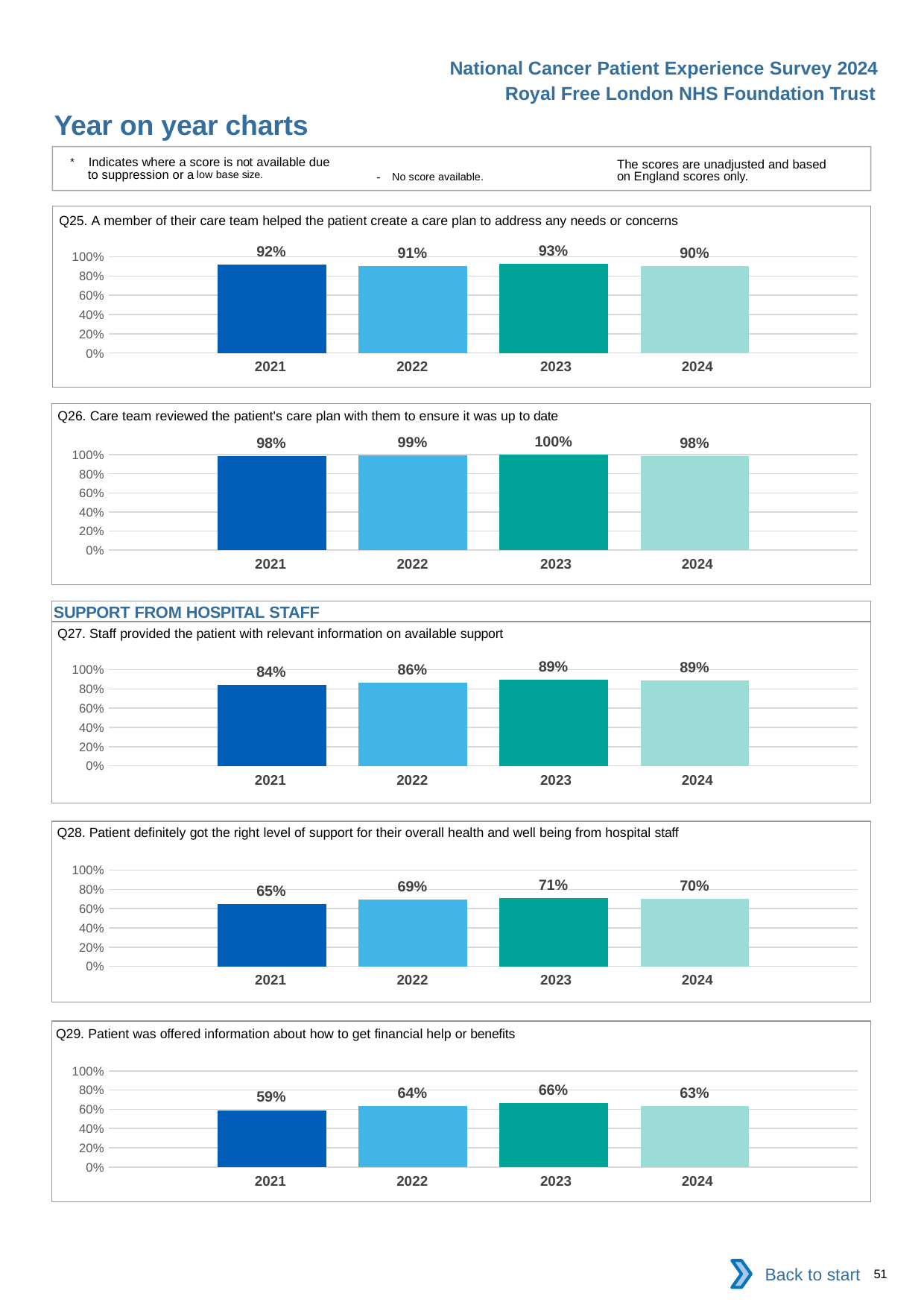
In the Q27 chart, what is the value for 2021? 84% In the Q25 chart, which year has the lowest value? 2024 In the Q28 chart, which year has the highest value? 2023 In the Q28 chart, what is the difference between the 2021 value and the 2023 value? 6 percentage points In the Q25 chart, what is the value for 2023? 93% In the Q29 chart, which is larger, the value for 2022 or the value for 2024? 2022 How many years are shown in the Q29 chart? 4 In the Q29 chart, what is the value for 2024? 63% In the Q26 chart, what is the value for 2023? 100% In the Q27 chart, do the values rise or fall from 2021 to 2023? rise In the Q26 chart, what is the difference between the 2023 value and the 2024 value? 2 percentage points What kind of chart is the Q28 chart? bar chart